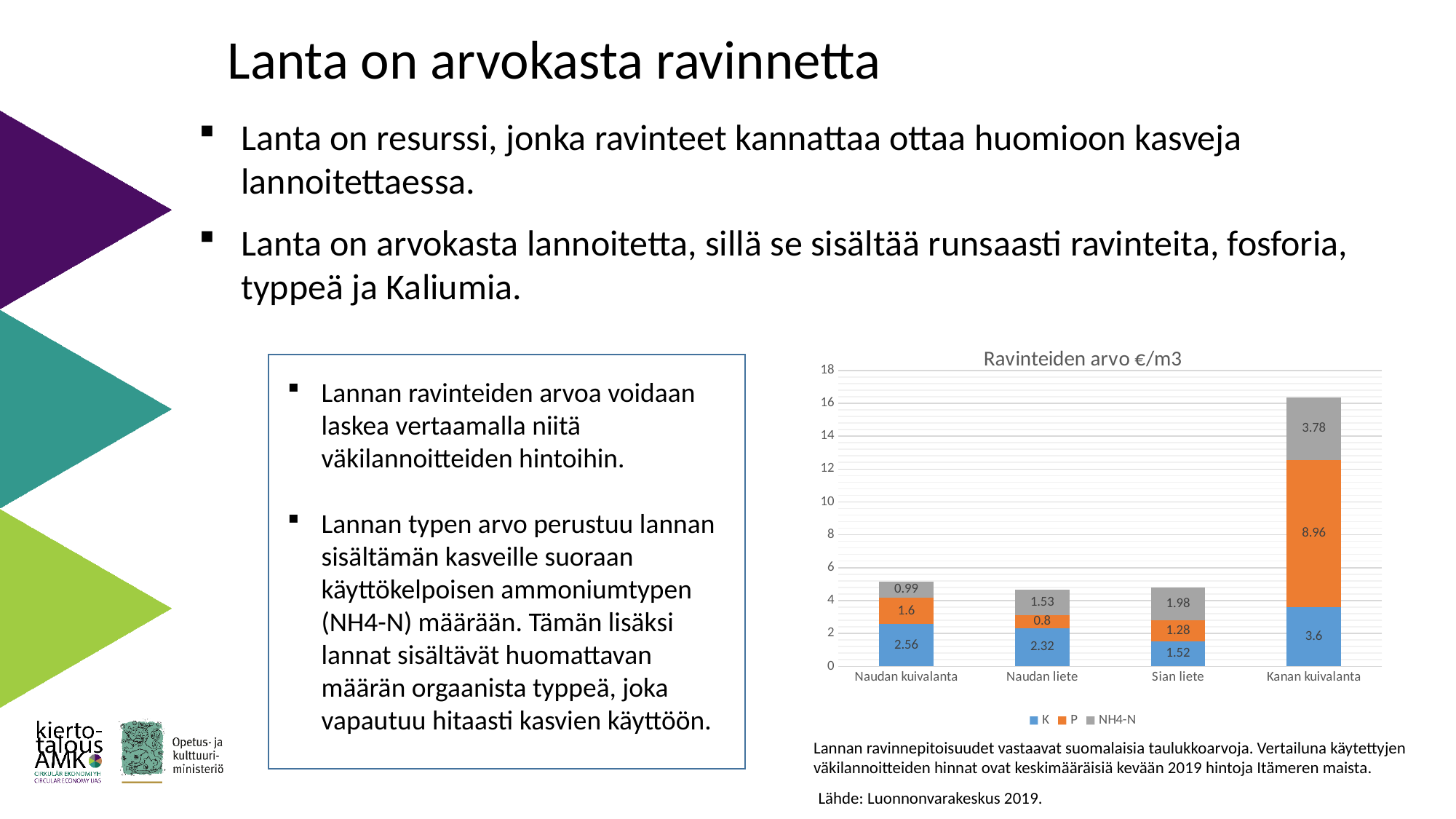
What is the difference between the P value for Kanan kuivalanta and the P value for Naudan kuivalanta? 7.36 Which category has the lowest value of K? Sian liete How many categories are shown on the x axis of the chart? 4 Which category has the highest total value in the chart? Kanan kuivalanta How many series does the chart legend list? 3 What is the value of NH4-N for Sian liete? 1.98 What is the value of P for Naudan liete? 0.8 What is the total of the stacked bar for Kanan kuivalanta? 16.34 What type of chart is shown on the slide? stacked bar chart Which is larger: the NH4-N value for Naudan liete or the NH4-N value for Naudan kuivalanta? Naudan liete What is the title of the chart? Ravinteiden arvo €/m3 What is the value of K for Kanan kuivalanta? 3.6